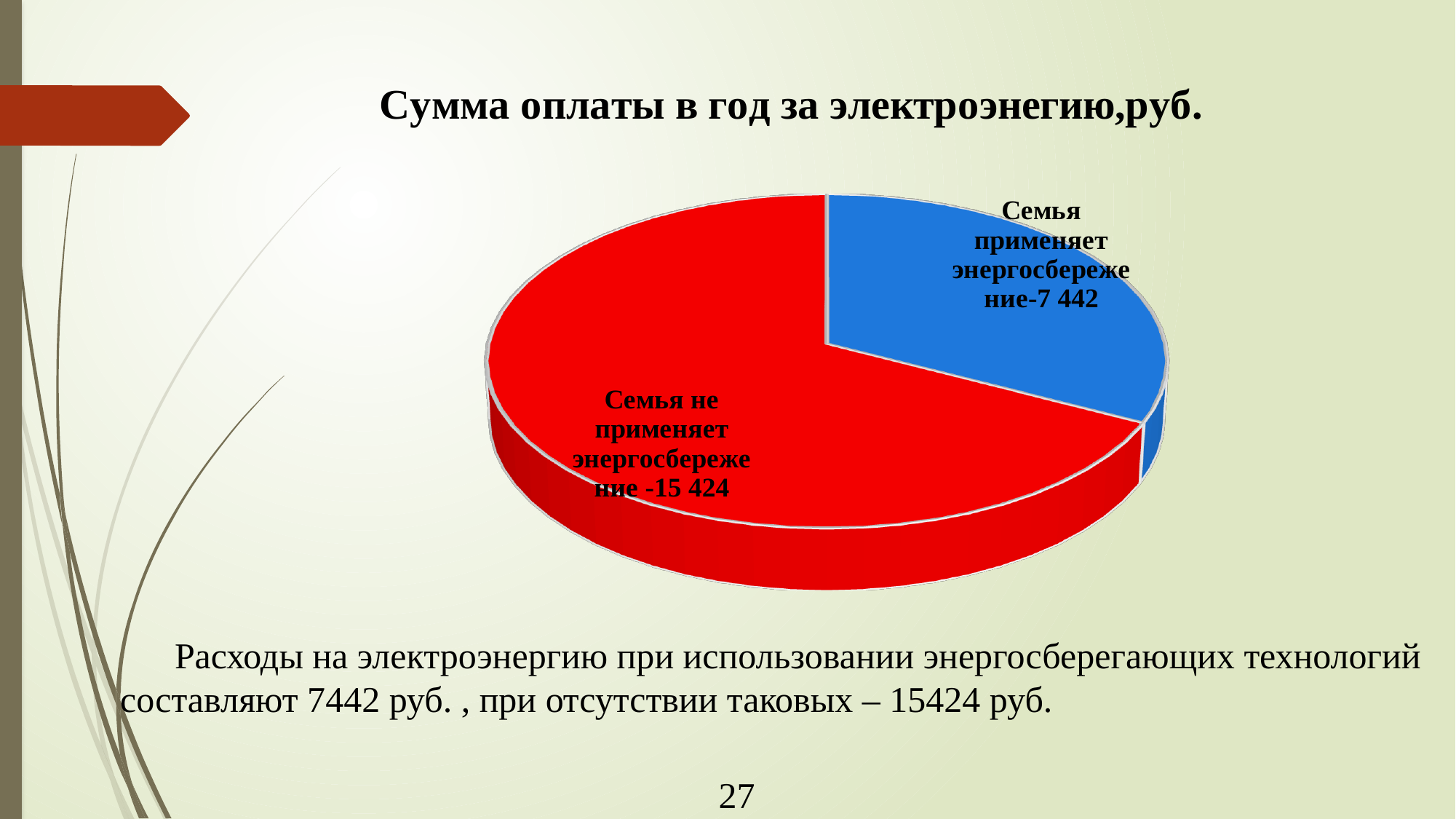
Which slice of the pie chart is the largest? Семья не применяет энергосбережение How many slices does the pie chart have? 2 Which slice of the pie chart is the smallest? Семья применяет энергосбережение What kind of chart is shown on the slide? Pie chart What is the total of the two values shown in the pie chart? 22 866 What is the value for the slice "Семья не применяет энергосбережение"? 15 424 Which is larger: the value for "Семья применяет энергосбережение" or the value for "Семья не применяет энергосбережение"? Семья не применяет энергосбережение What is the title of the chart? Сумма оплаты в год за электроэнегию,руб. What colour is the slice for "Семья не применяет энергосбережение"? Red What is the difference between the value for "Семья не применяет энергосбережение" and the value for "Семья применяет энергосбережение"? 7 982 What share of the pie does the slice "Семья применяет энергосбережение" represent? 32.5% What is the value for the slice "Семья применяет энергосбережение"? 7 442